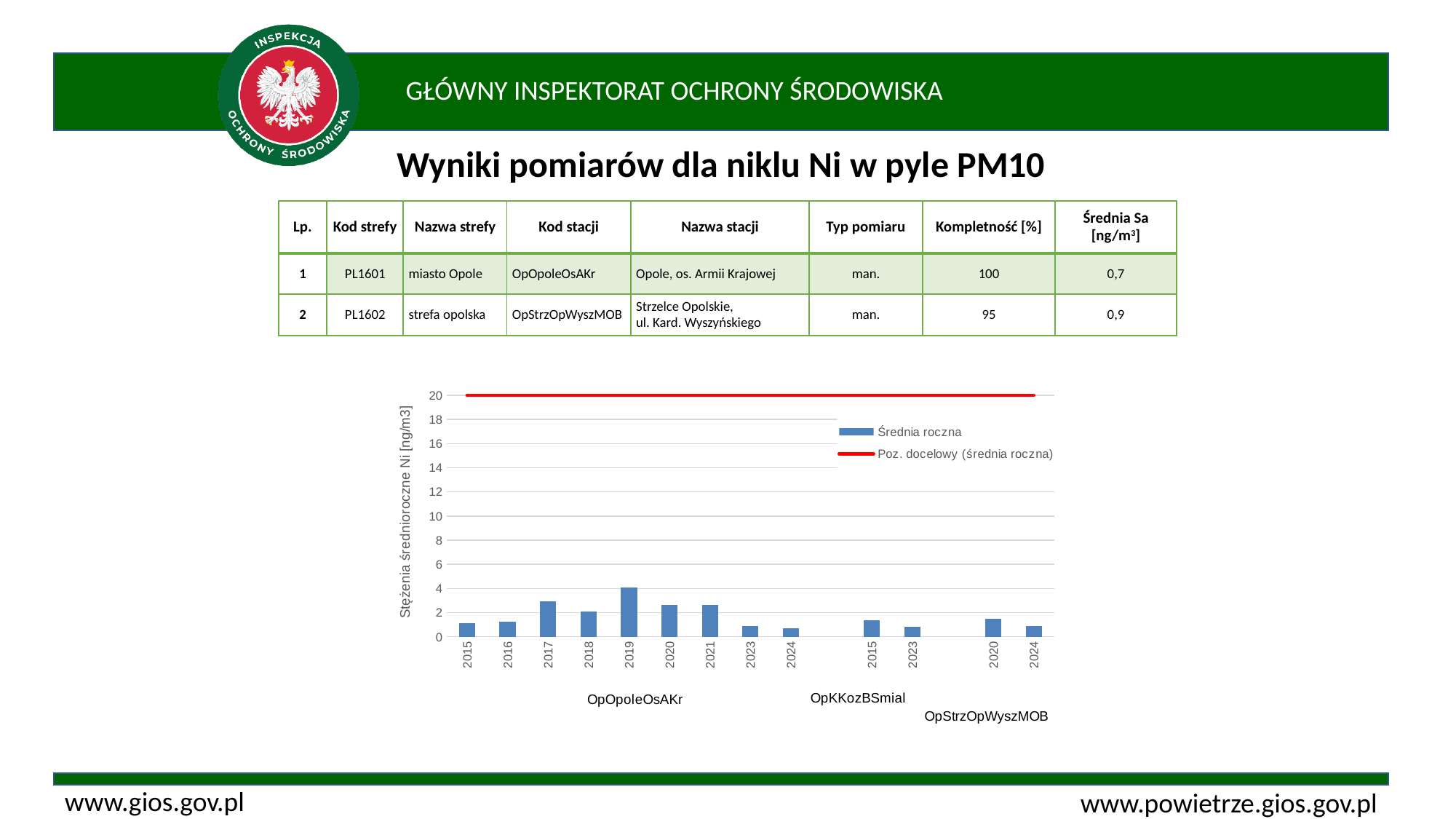
Is the value for 2015 at OpOpoleOsAKr greater or less than 2? less Which year has the highest bar in the chart? 2019 (OpOpoleOsAKr) At OpOpoleOsAKr, which is larger: the value for 2018 or the value for 2019? 2019 What is the label of the vertical axis of the chart? Stężenia średnioroczne Ni [ng/m3] At OpOpoleOsAKr, do the values rise or fall from 2019 to 2024? fall How many years are plotted for the station OpOpoleOsAKr? 9 What are the two entries in the chart legend? Średnia roczna; Poz. docelowy (średnia roczna) What is the value of the red target line (Poz. docelowy) in the chart? 20 Is the value for 2019 at OpOpoleOsAKr greater or less than 2? greater How many series does the chart legend list? 2 What kind of chart is shown on the slide? combination bar and line chart How many bars are plotted in the chart in total? 13